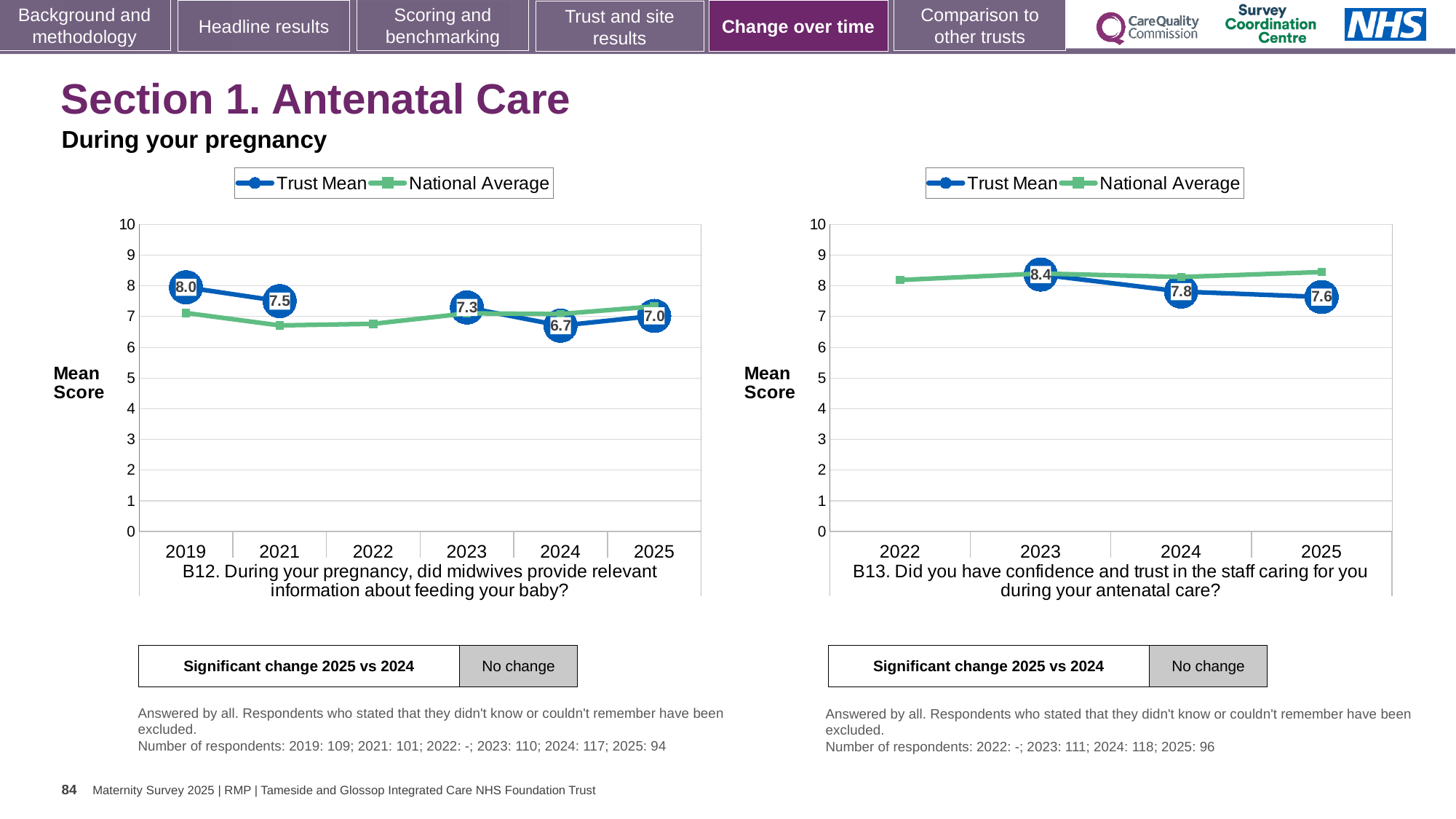
In the B12 chart, which year has the lowest Trust Mean? 2024 In the B12 chart, is the National Average for 2021 greater or less than 7? less What kind of chart is the B12 chart? line chart In the B13 chart, which is larger in 2025, the Trust Mean or the National Average? National Average In the B13 chart, what is the Trust Mean for 2025? 7.6 In the B13 chart, what is the Trust Mean for 2023? 8.4 How many series does the legend of the B13 chart list? 2 In the B12 chart, which year has the highest Trust Mean? 2019 In the B13 chart, does the Trust Mean rise or fall from 2023 to 2025? fall In the B12 chart, what is the difference between the Trust Mean in 2019 and in 2025? 1.0 In the B12 chart, what is the Trust Mean for 2019? 8.0 In the B12 chart, what is the Trust Mean for 2024? 6.7